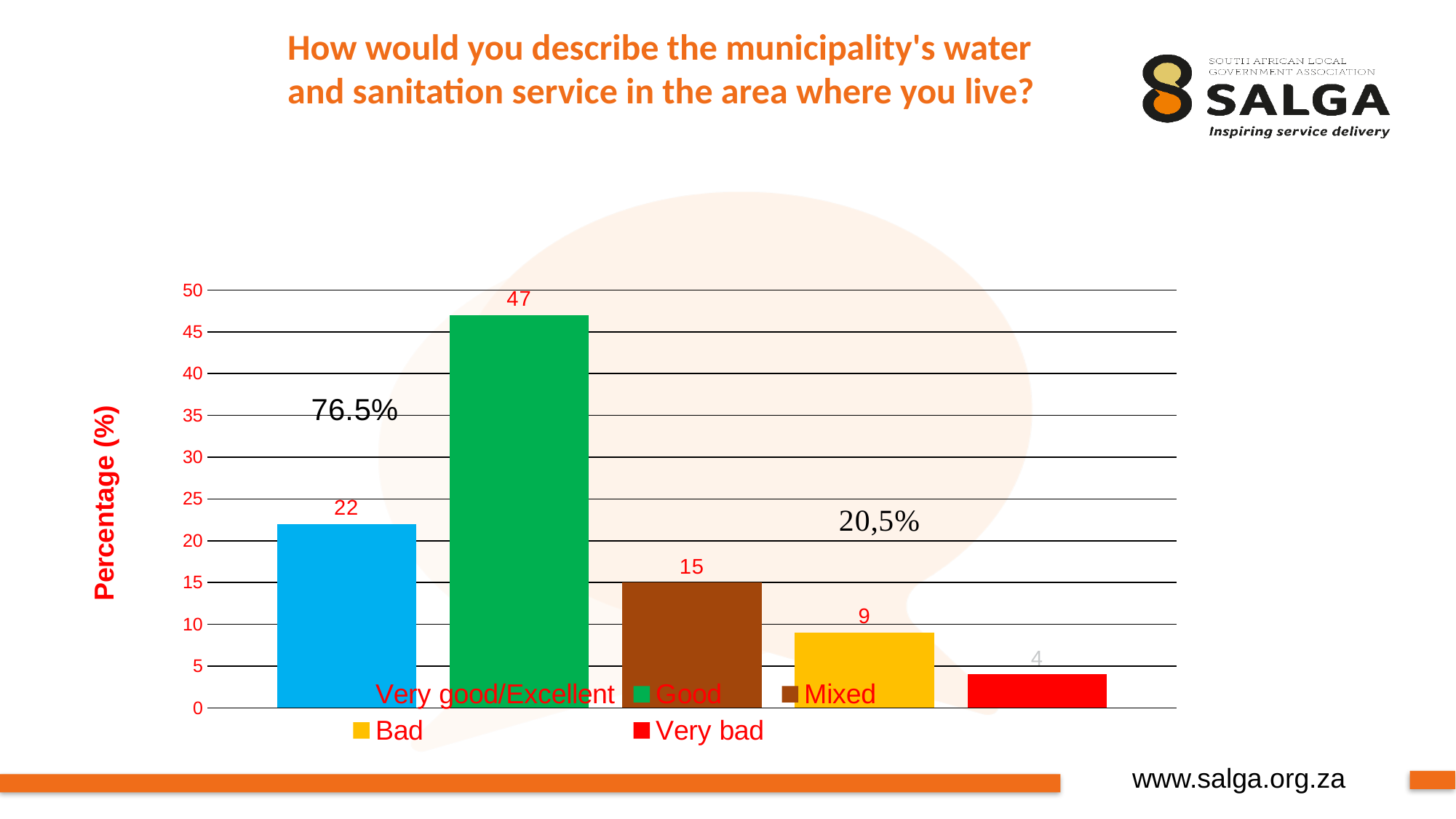
What is the value for Very good/Excellent? 22 What is the value for Very bad? 4 What is the value for Mixed? 15 How many categories does the legend list? 5 What is the value for Good? 47 Which category has the lowest value? Very bad What is the value for Bad? 9 What is the label of the vertical axis? Percentage (%) Which category has the highest value? Good What is the difference between the values for Good and Very good/Excellent? 25 Which is larger, the value for Mixed or the value for Bad? Mixed What kind of chart is shown on the slide? Bar chart